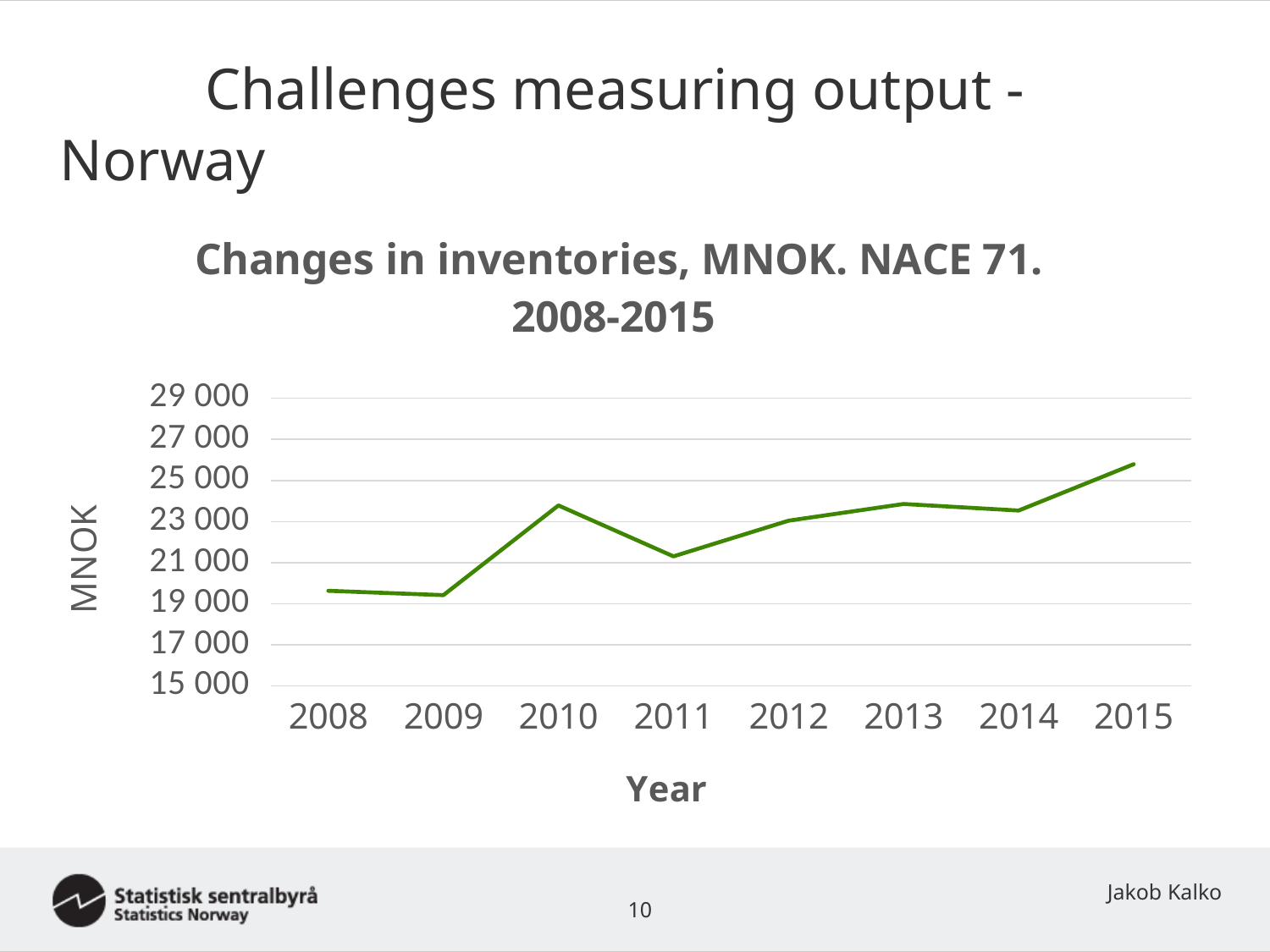
Is the value for 2008 greater or less than 19 000? greater Is the value for 2013 greater or less than 25 000? less What type of chart is shown on the slide? Line chart Is the value for 2011 greater or less than 23 000? less What is the label on the y axis of the chart? MNOK Which year has the larger value, 2010 or 2011? 2010 How many years are plotted on the x axis of the chart? 8 Which year has the larger value, 2008 or 2015? 2015 Overall, do the values rise or fall from 2008 to 2015? rise Which year has the highest value for changes in inventories? 2015